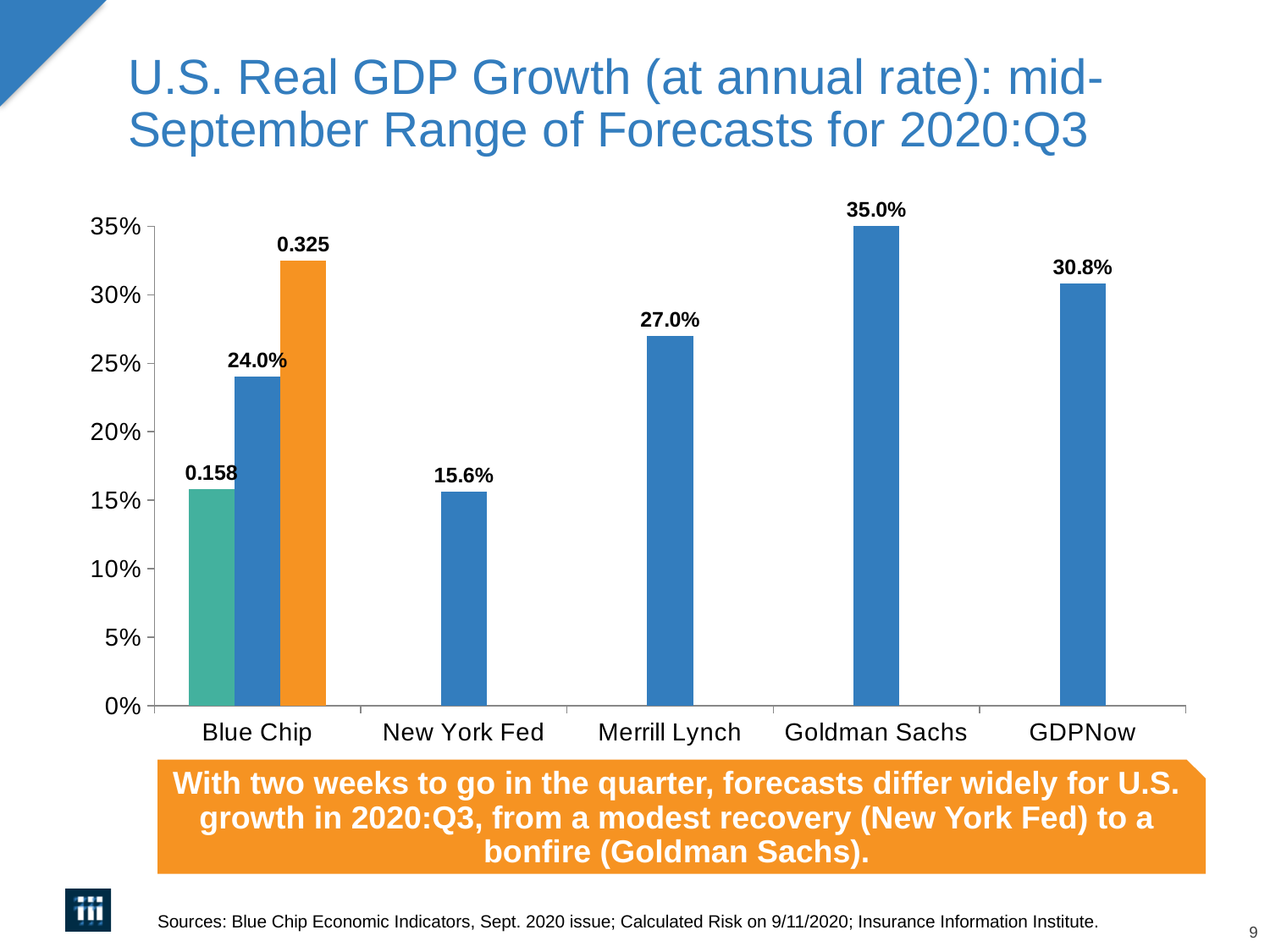
Is the value for Merrill Lynch greater or less than 25%? greater Among New York Fed, Merrill Lynch, Goldman Sachs and GDPNow, which has the lowest value? New York Fed What is the difference between the Goldman Sachs value and the New York Fed value? 19.4 percentage points How many categories are shown on the x axis? 5 What is the value shown for New York Fed? 15.6% What is the value shown for Goldman Sachs? 35.0% What kind of chart is shown on the slide? Bar chart What is the value shown for GDPNow? 30.8% What value is labelled on the green bar in the Blue Chip group? 0.158 Which is larger, the value for Merrill Lynch or the value for GDPNow? GDPNow Which forecaster has the highest value on the chart? Goldman Sachs What value is labelled on the orange bar in the Blue Chip group? 0.325